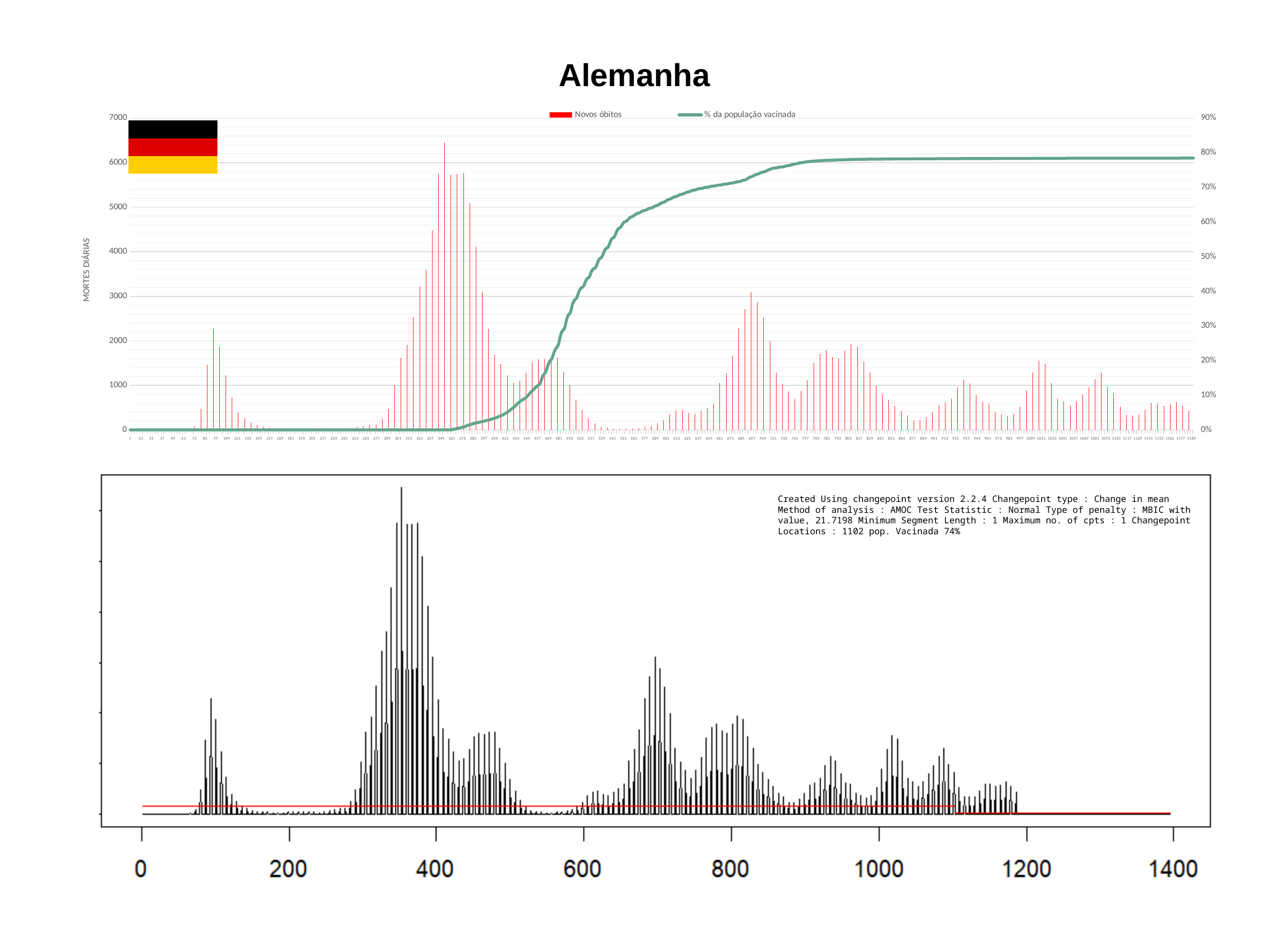
In the top chart, does the % da população vacinada line rise or fall along the x axis? rise In the bottom chart, what is the highest tick shown on the x axis? 1400 In the top chart, what are the two legend entries? Novos óbitos; % da população vacinada In the top chart, what kind of chart is used to show Novos óbitos? bar chart In the top chart, how many series does the legend list? 2 In the bottom chart, what percentage of the population is stated as vaccinated (pop. Vacinada) in the text box? 74% In the top chart, is the highest value of Novos óbitos greater or less than 6000? greater In the top chart, is the final value of % da população vacinada greater or less than 70%? greater In the top chart, what is the highest tick on the right vertical axis? 90% What is the title of the slide's top chart? Alemanha In the bottom chart, what changepoint location is stated in the text box? 1102 In the top chart, what is the highest tick on the left vertical axis? 7000